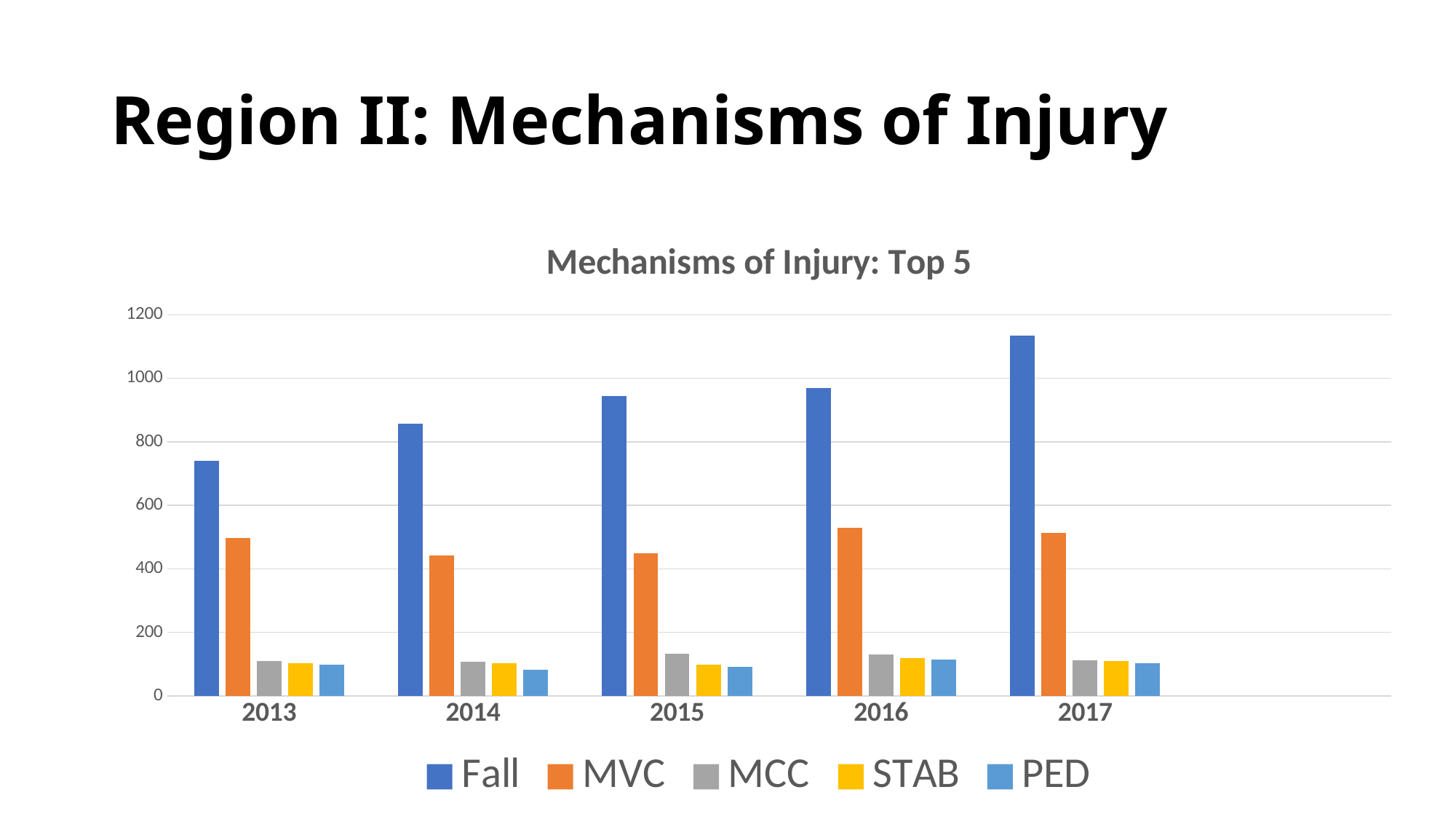
What kind of chart is shown on the slide? bar chart How many series does the legend list? 5 Is the Fall value for 2017 greater or less than 1000? greater How many years are shown on the x axis? 5 Is the MVC value for 2016 greater or less than 400? greater What is the title of the chart? Mechanisms of Injury: Top 5 In which year is the Fall value lowest? 2013 In which year is the Fall value highest? 2017 Is the Fall value for 2013 greater or less than 800? less Do the Fall values rise or fall from 2013 to 2017? rise Which is larger in 2015, the Fall value or the MVC value? Fall Which series is shown in orange? MVC